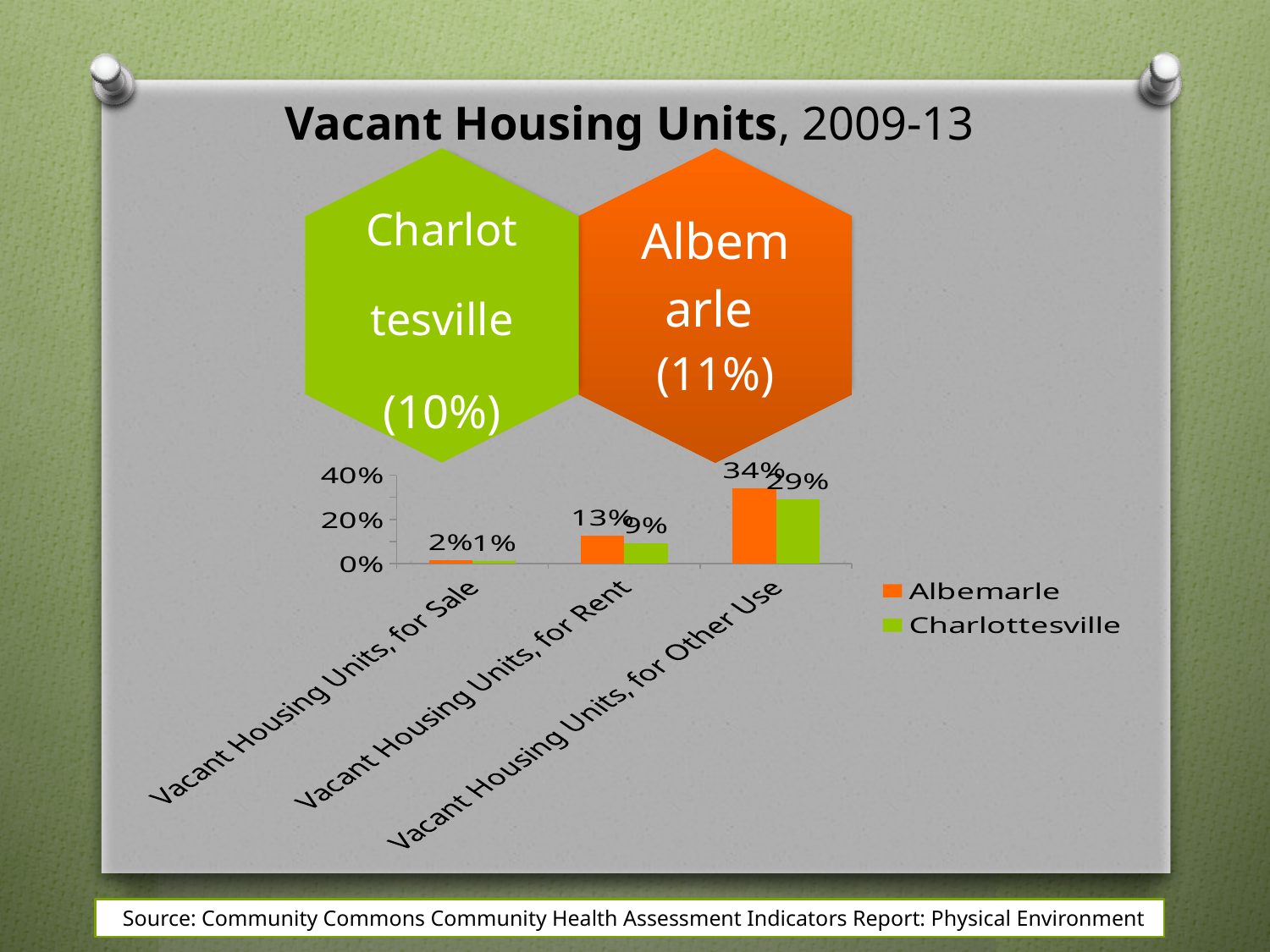
How many series does the legend list? 2 What is the value for Charlottesville for Vacant Housing Units, for Rent? 9% How many categories are shown on the x axis? 3 What is the difference between Albemarle and Charlottesville for Vacant Housing Units, for Other Use? 5% Which category has the lowest value for Charlottesville? Vacant Housing Units, for Sale Which category has the highest value for Albemarle? Vacant Housing Units, for Other Use What kind of chart is shown on the slide? bar chart What is the value for Albemarle for Vacant Housing Units, for Other Use? 34% Is the value for Albemarle for Vacant Housing Units, for Other Use greater or less than 20%? greater What is the value for Albemarle for Vacant Housing Units, for Sale? 2% Which is larger for Vacant Housing Units, for Rent: Albemarle or Charlottesville? Albemarle What is the value for Charlottesville for Vacant Housing Units, for Other Use? 29%